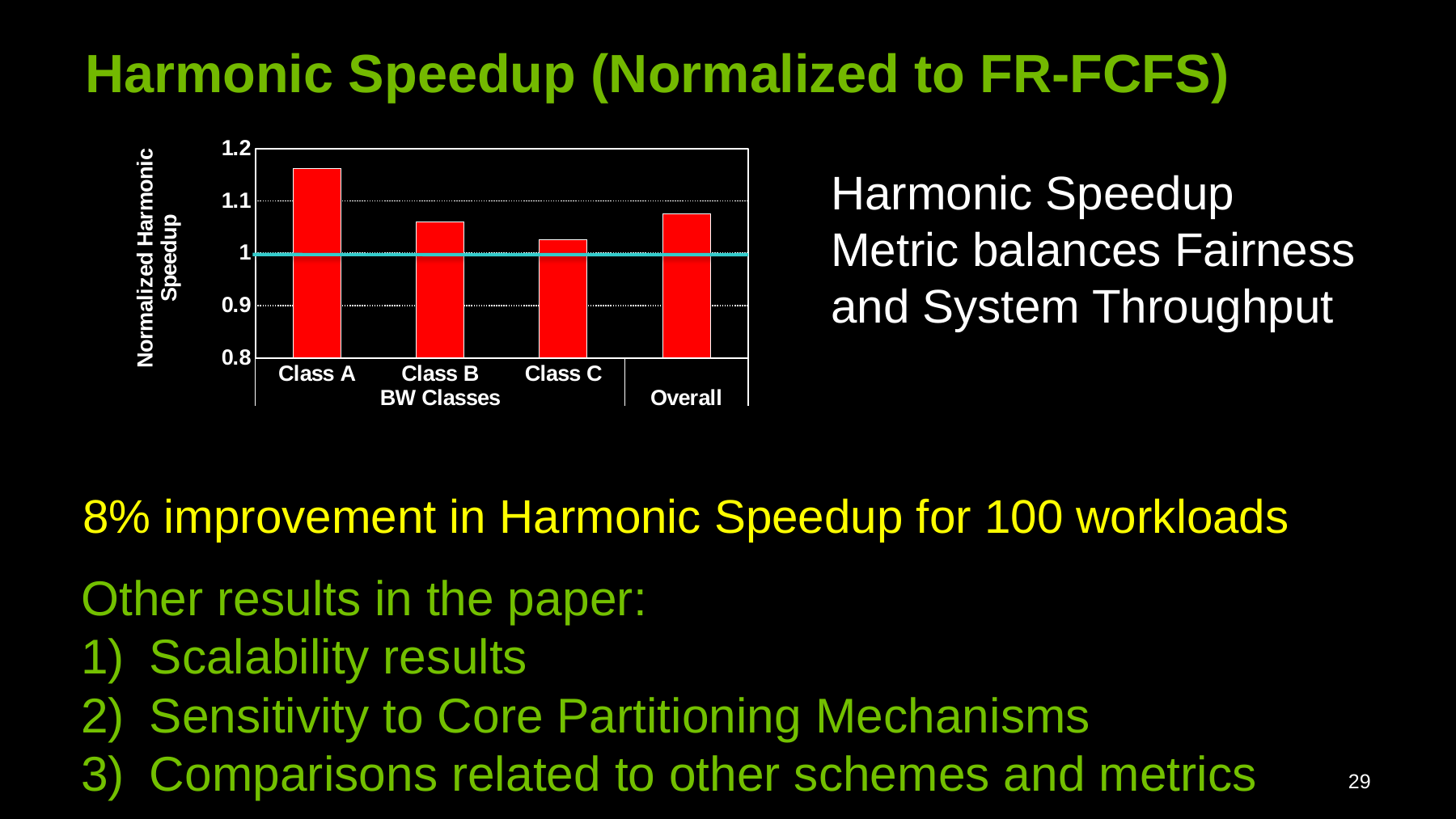
Which category has the highest normalized harmonic speedup? Class A Is the value for Overall greater or less than 1.1? less How many bars are plotted in the chart? 4 Which category has the lowest normalized harmonic speedup? Class C What is the label under the Class A, Class B and Class C bars on the x axis? BW Classes Is the value for Class B greater or less than 1.1? less Which is larger, the value for Class B or the value for Class C? Class B Is the value for Class C greater or less than 1? greater What kind of chart is shown on the slide? bar chart What is the label on the y axis of the chart? Normalized Harmonic Speedup Which is larger, the value for Class A or the value for Class B? Class A